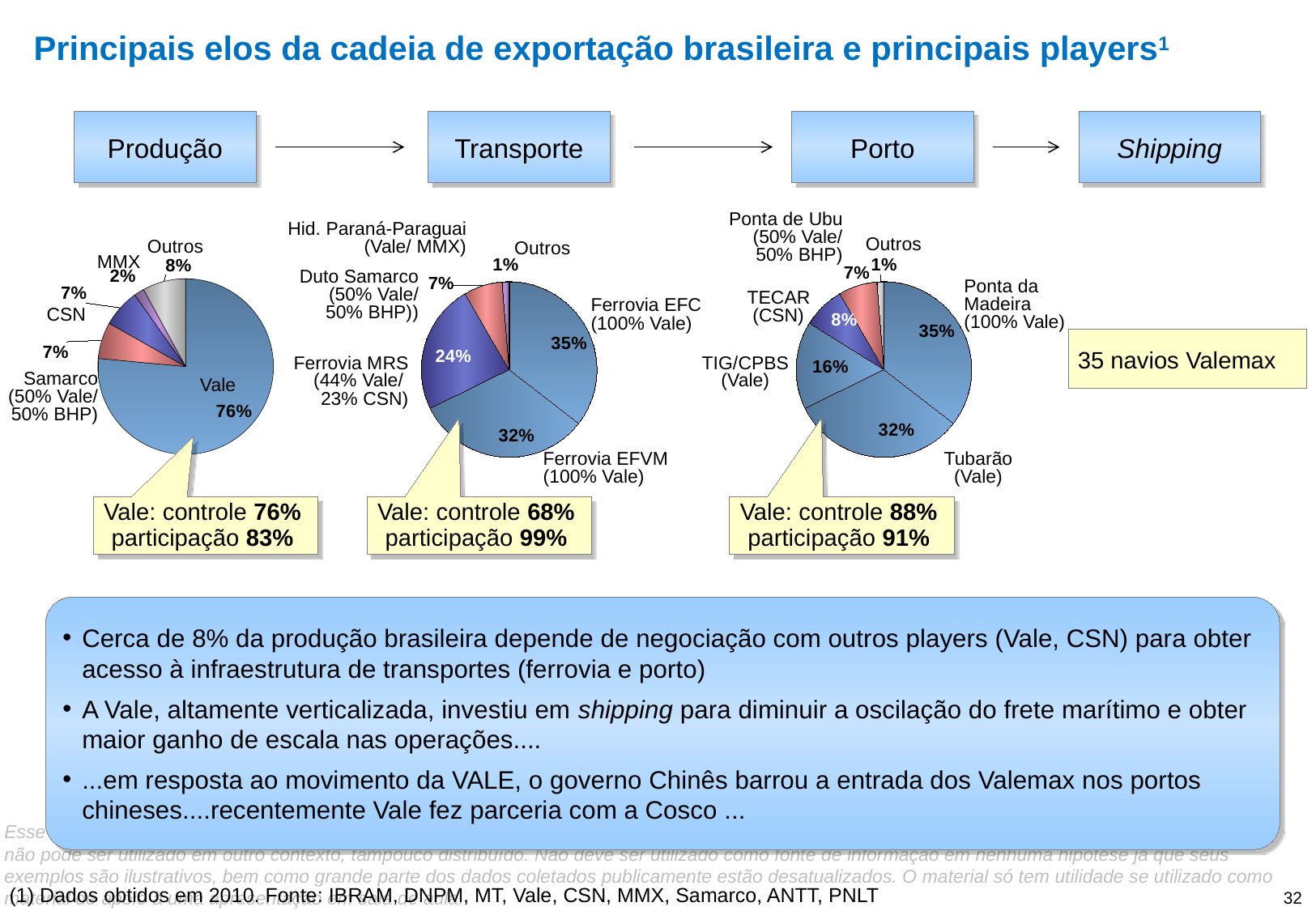
In the Transporte pie chart, what share does Ferrovia EFC have? 35% In the Produção pie chart, what is the share for Outros? 8% In the Produção pie chart, which player has the smallest share? MMX In the Porto pie chart, what share does Tubarão have? 32% In the Produção pie chart, what share does Vale hold? 76% In the Porto pie chart, which port has the largest share? Ponta da Madeira In the Transporte pie chart, which is larger: Ferrovia EFVM or Duto Samarco? Ferrovia EFVM What type of chart is used under Produção, Transporte and Porto? Pie chart In the Transporte pie chart, what share does Ferrovia MRS have? 24% In the Transporte pie chart, what is the difference between Ferrovia EFC and Ferrovia EFVM? 3% In the Produção pie chart, what is the difference between Vale's share and Outros' share? 68% In the Porto pie chart, what is the share for TIG/CPBS? 16%